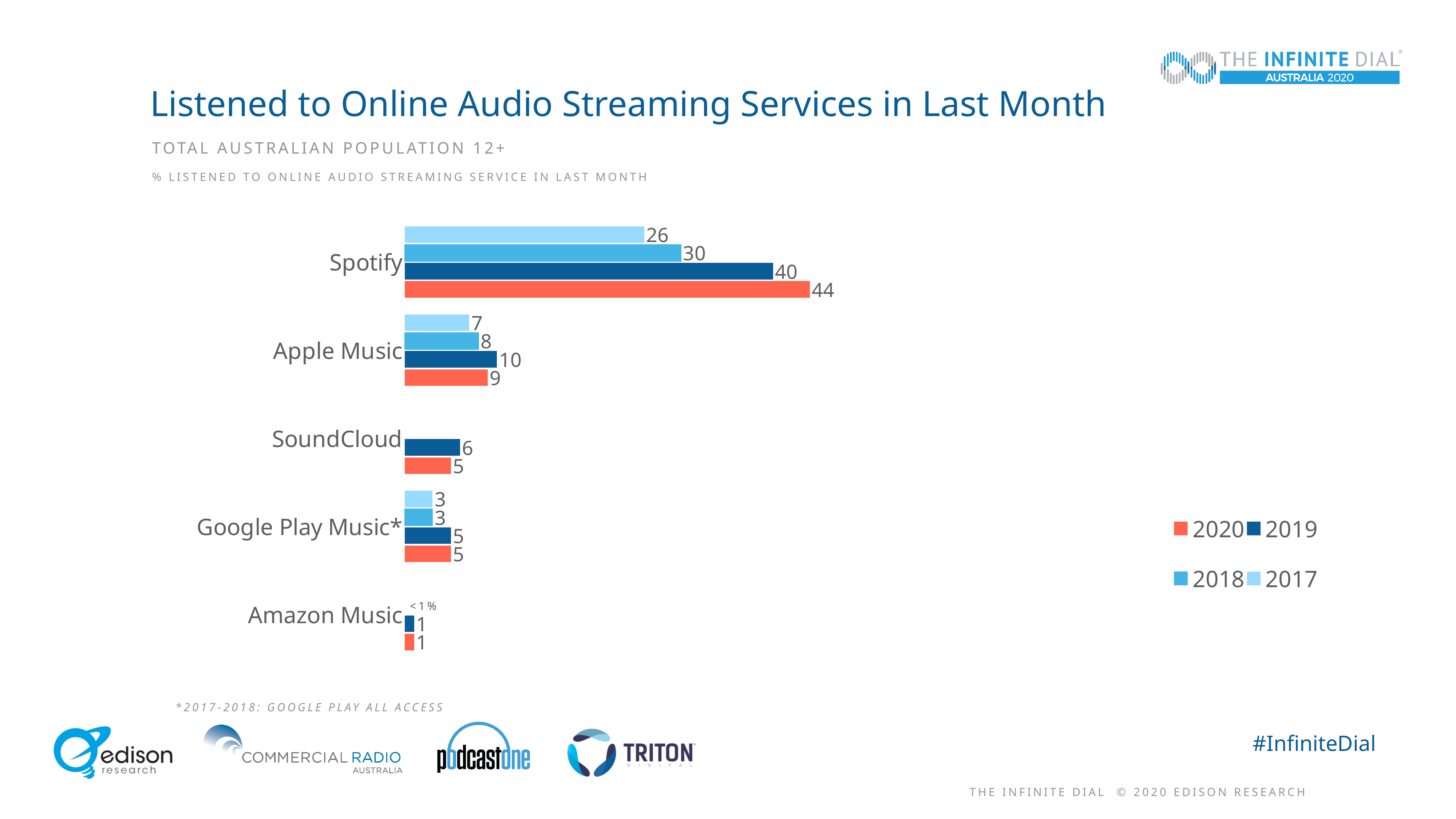
What is the 2017 value for Apple Music? 7 How many series does the legend list? 4 Which service has the highest 2020 value? Spotify Which is larger for Apple Music: the 2019 value or the 2020 value? 2019 What is the 2020 value for Spotify? 44 What is the 2019 value for SoundCloud? 6 Which colour represents 2020 in the legend? Orange-red What is the difference between Spotify's 2020 and 2017 values? 18 What is the difference between Spotify's 2020 and 2019 values? 4 How many services are shown on the chart? 5 What kind of chart is shown on the slide? Bar chart Which service has the lowest 2019 value? Amazon Music